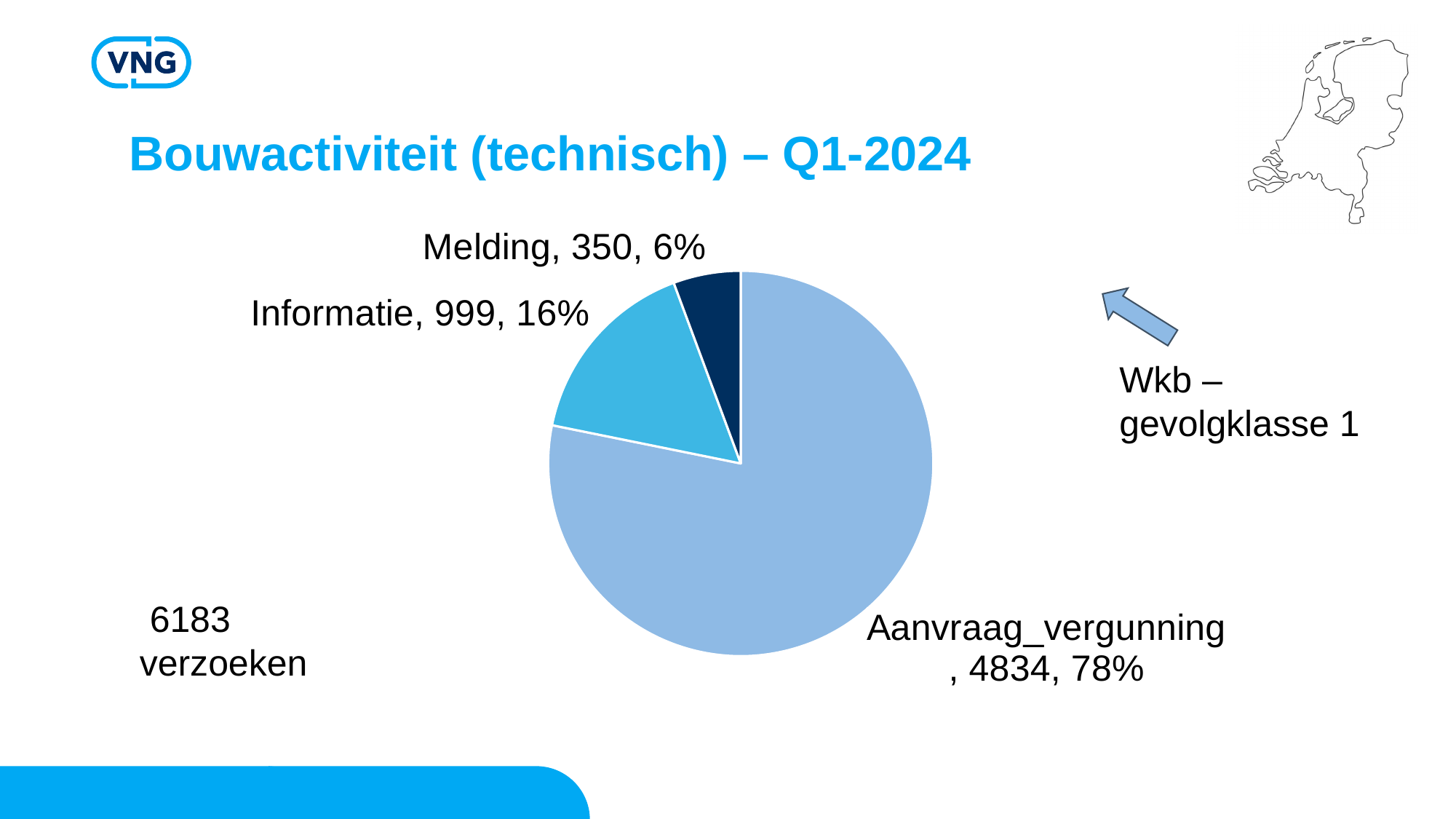
What is the value for Informatie? 999 What is the value for Aanvraag_vergunning? 4834 What share of the pie does Melding represent? 6% What kind of chart is shown on the slide? pie chart How many slices does the pie chart have? 3 What is the difference between the values for Informatie and Melding? 649 What is the title of the slide containing the chart? Bouwactiviteit (technisch) – Q1-2024 What share of the pie does Informatie represent? 16% What is the value for Melding? 350 What share of the pie does Aanvraag_vergunning represent? 78% Which category has the largest slice? Aanvraag_vergunning Which category has the smallest slice? Melding